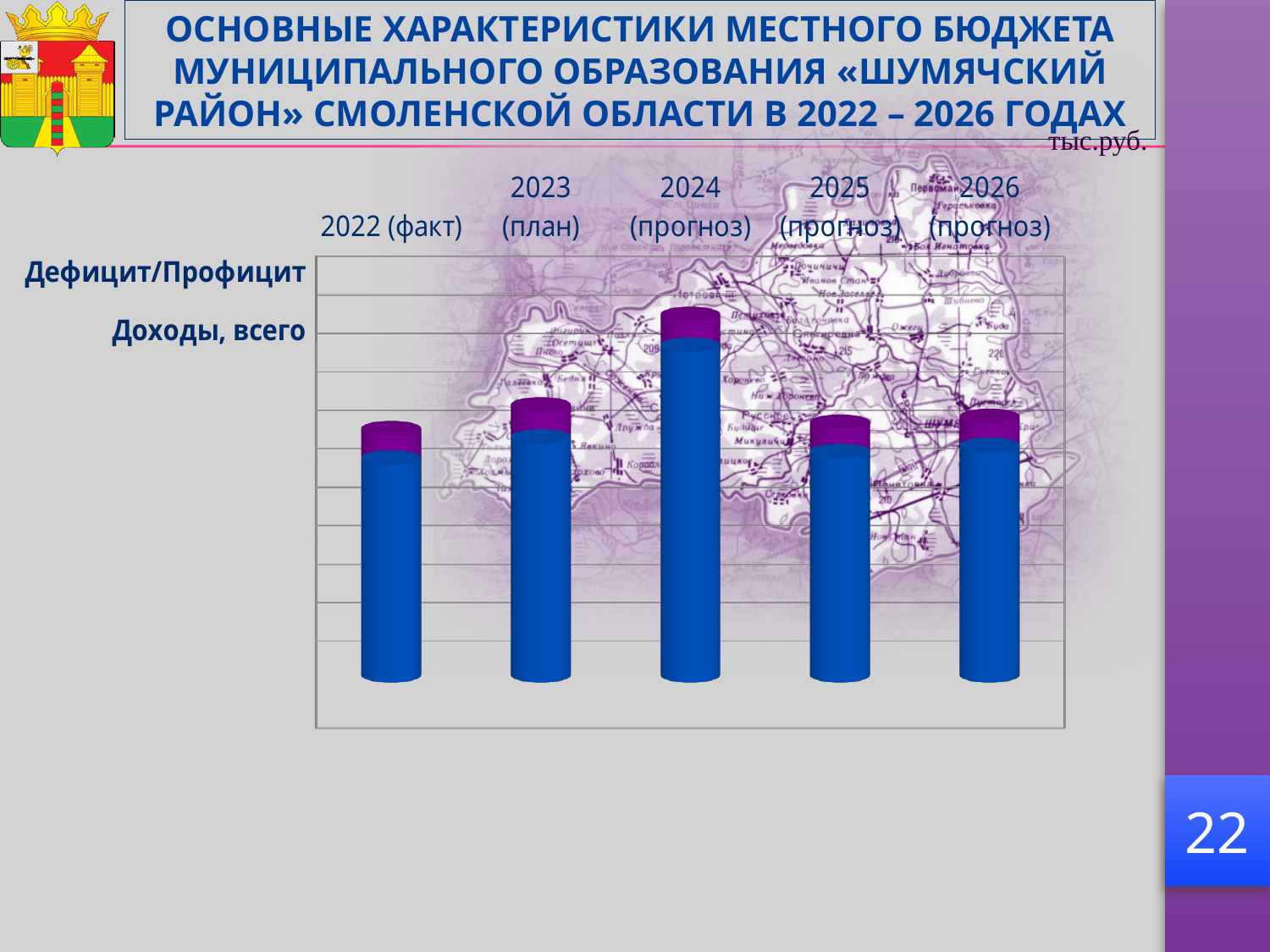
Which bar is taller, 2023 (план) or 2022 (факт)? 2023 (план) How many year categories are plotted on the chart? 5 What kind of chart is shown on the slide? bar chart Which year has the tallest bar on the chart? 2024 (прогноз) What unit of measurement is indicated for the chart? тыс.руб. Which bar is taller, 2024 (прогноз) or 2022 (факт)? 2024 (прогноз) Which bar is taller, 2024 (прогноз) or 2025 (прогноз)? 2024 (прогноз) Do the bars rise or fall from 2022 (факт) to 2024 (прогноз)? rise Do the bars rise or fall from 2024 (прогноз) to 2025 (прогноз)? fall